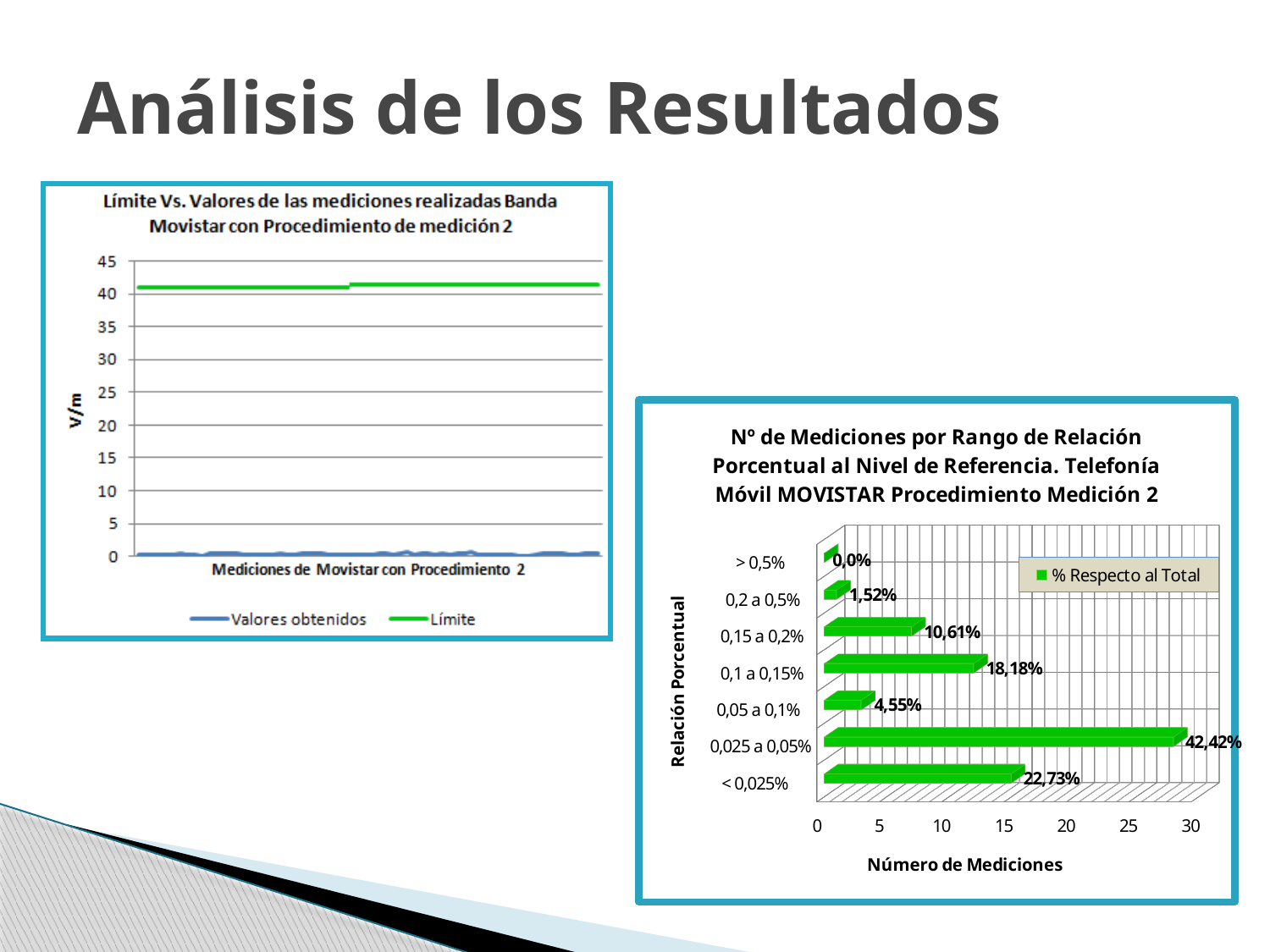
On the left chart (Límite Vs. Valores de las mediciones realizadas), is the Límite line greater or less than 40 V/m? greater On the right chart (Nº de Mediciones por Rango de Relación Porcentual), which range has the highest value? 0,025 a 0,05% On the right chart (Nº de Mediciones por Rango de Relación Porcentual), what is the value for the range 0,025 a 0,05%? 42,42% On the right chart (Nº de Mediciones por Rango de Relación Porcentual), how many ranges are shown on the vertical axis? 7 On the right chart (Nº de Mediciones por Rango de Relación Porcentual), how many series does the legend list? 1 On the right chart (Nº de Mediciones por Rango de Relación Porcentual), which is larger: the value for 0,15 a 0,2% or the value for 0,05 a 0,1%? 0,15 a 0,2% On the left chart (Límite Vs. Valores de las mediciones realizadas), how many series does the legend list? 2 What kind of chart is the right chart (Nº de Mediciones por Rango de Relación Porcentual)? Bar chart On the right chart (Nº de Mediciones por Rango de Relación Porcentual), what is the difference between the values for 0,025 a 0,05% and < 0,025%? 19,69% On the right chart (Nº de Mediciones por Rango de Relación Porcentual), which range has the lowest value? > 0,5% On the right chart (Nº de Mediciones por Rango de Relación Porcentual), what is the value for the range < 0,025%? 22,73% On the right chart (Nº de Mediciones por Rango de Relación Porcentual), what is the value for the range 0,1 a 0,15%? 18,18%